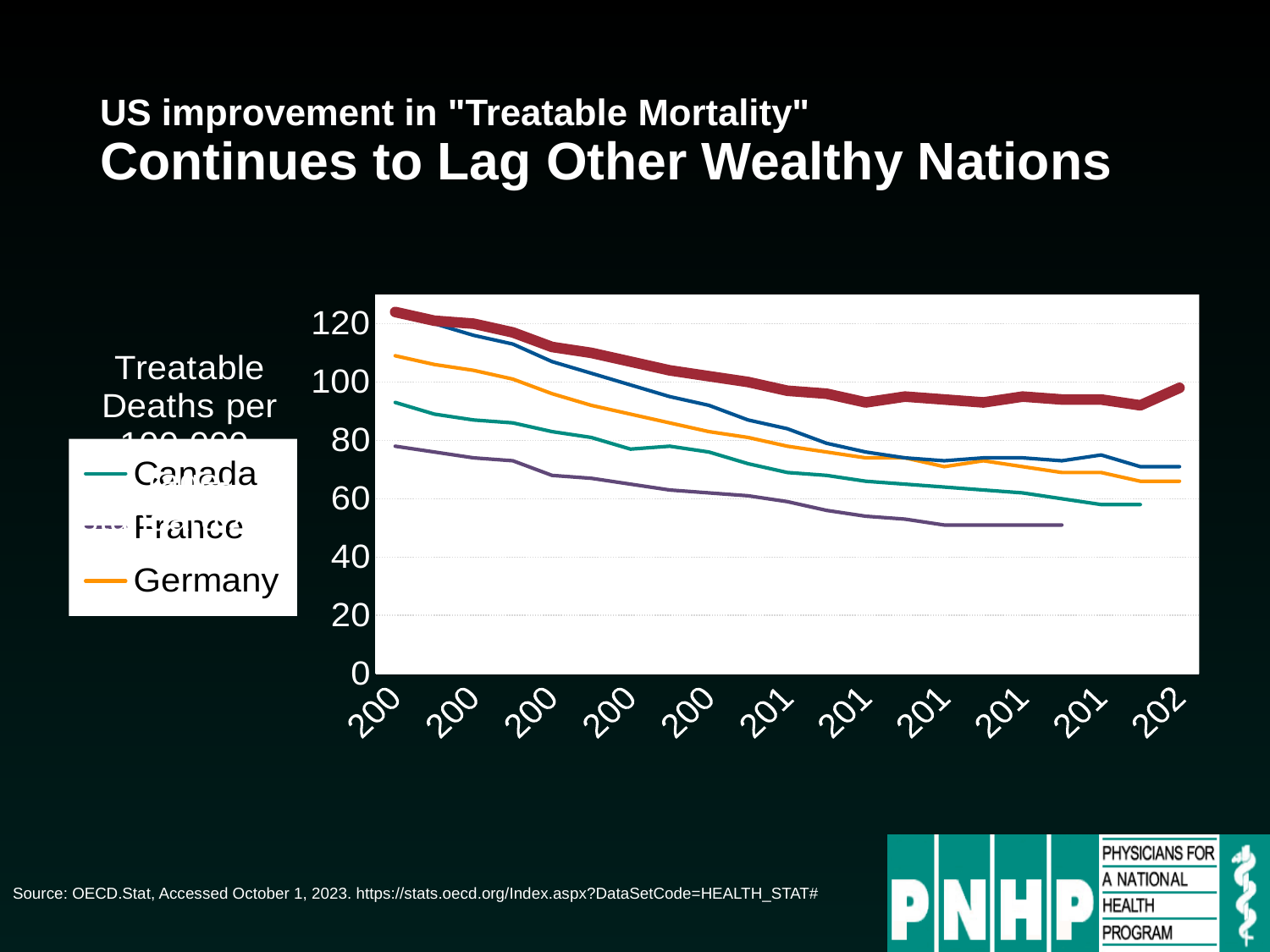
Of the countries named in the legend, which has the highest treatable deaths per 100,000 at the start of the period? Germany At the end of its line, is the value for France greater or less than 60? less Does the line for Canada rise or fall over the years shown? fall Which three countries are listed in the chart's legend? Canada, France, Germany At the start of the period, which is higher: Canada or France? Canada Of the countries named in the legend, which has the lowest treatable deaths per 100,000 throughout the period? France Does the line for Germany rise or fall over the years shown? fall At the end of the period, is the value for Germany greater or less than 60? greater What colour is the line for Germany? orange At the start of the period, is the value for Germany greater or less than 100? greater What is the highest value shown on the vertical axis? 120 What kind of chart is shown on the slide? line chart